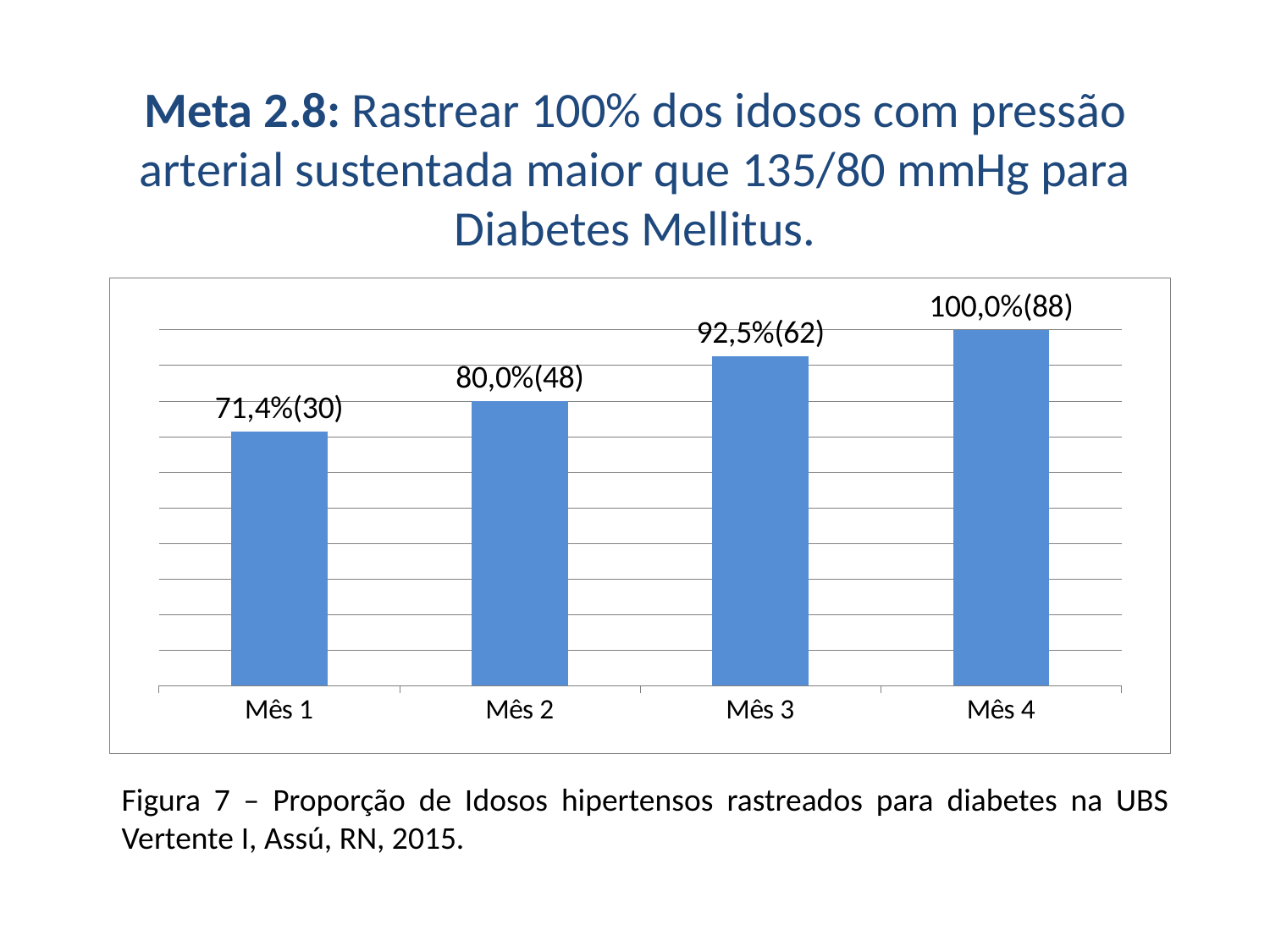
Which is larger, the value for Mês 2 or the value for Mês 3? Mês 3 Which month has the lowest value? Mês 1 What is the data label shown for Mês 1? 71,4%(30) Which month has the highest value? Mês 4 What is the data label shown for Mês 2? 80,0%(48) What is the data label shown for Mês 4? 100,0%(88) What is the data label shown for Mês 3? 92,5%(62) What kind of chart is shown on the slide? Bar chart What is the difference in percentage points between Mês 3 and Mês 2? 12,5 Do the values rise or fall from Mês 1 to Mês 4? Rise How many months (categories) are shown on the x axis? 4 What is the difference in percentage points between Mês 4 and Mês 1? 28,6